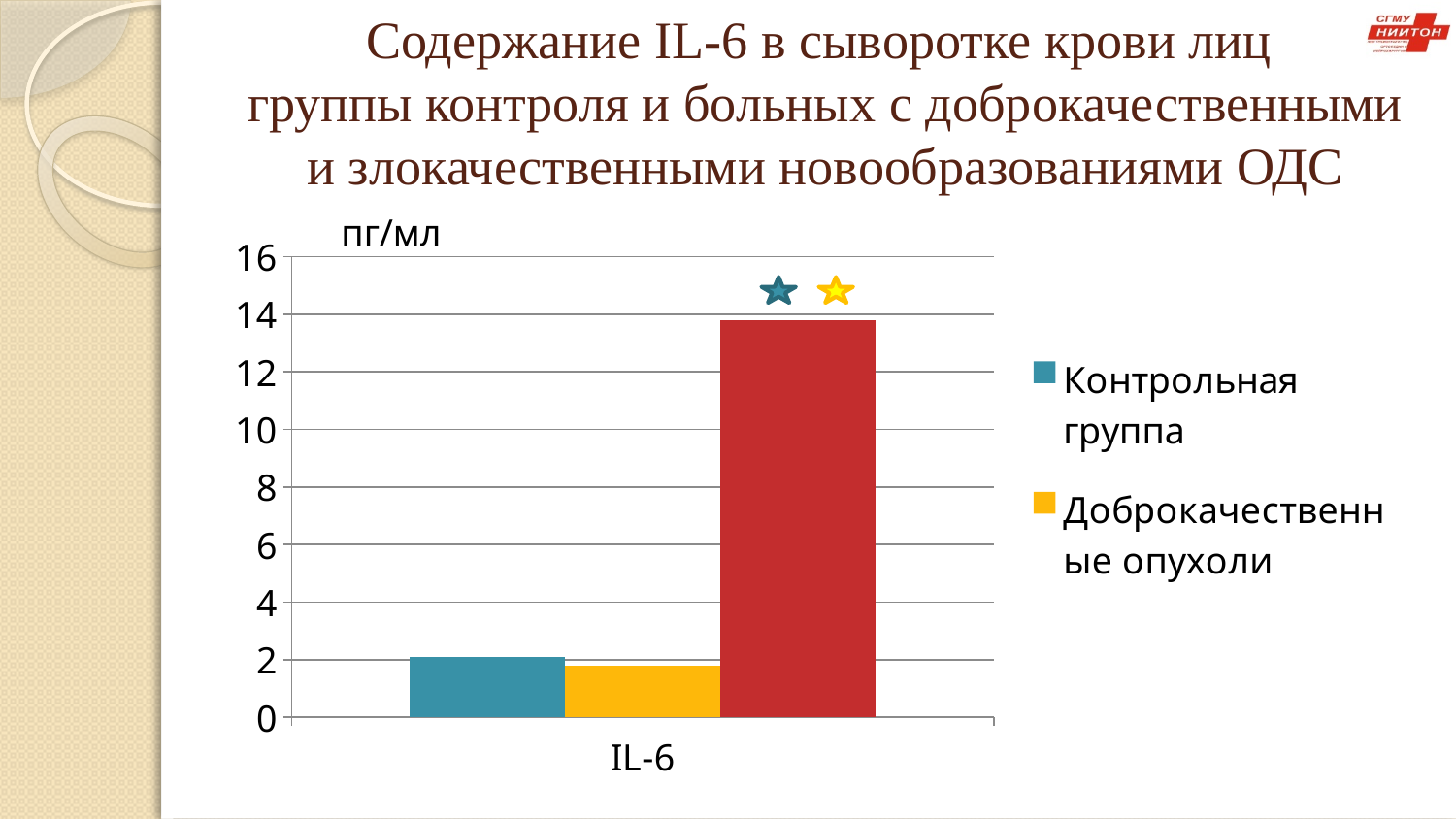
How many categories are shown on the x axis of the chart? 1 What is the category label on the x axis of the chart? IL-6 What kind of chart is shown on the slide? bar chart Is the value for Контрольная группа greater or less than 4? less Is the value for Доброкачественные опухоли greater or less than 4? less What is the maximum value shown on the y axis of the chart? 16 How many series does the legend of the chart list? 2 Is the value of the red bar greater or less than 12? greater Which is larger, the value for Контрольная группа or for Доброкачественные опухоли? Контрольная группа Which bar in the chart is the tallest? the red bar What unit is shown on the y axis of the chart? пг/мл